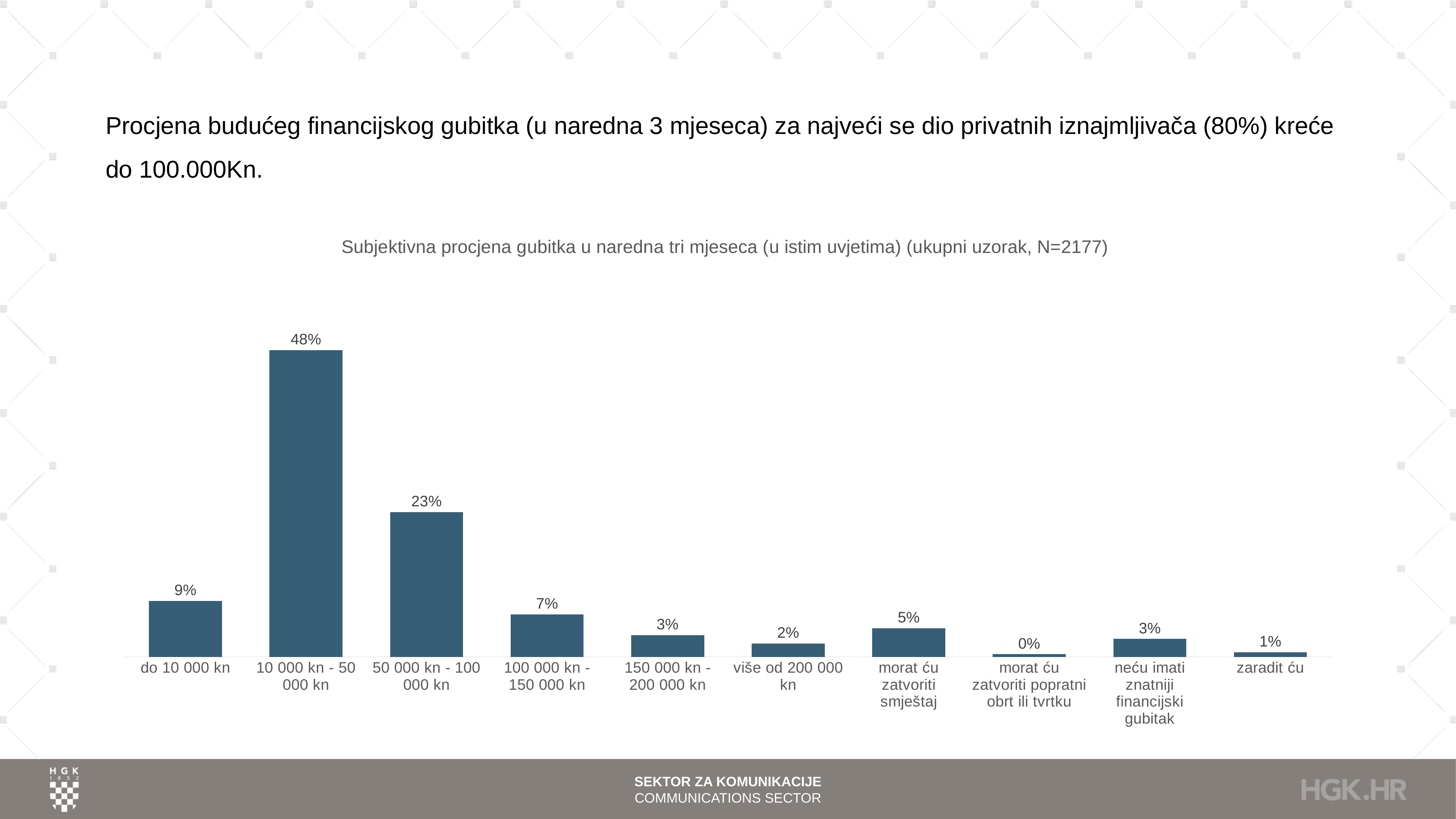
What is the value for the category "10 000 kn - 50 000 kn"? 48% What is the value for the category "zaradit ću"? 1% What is the value for the category "morat ću zatvoriti smještaj"? 5% Which category has the highest value? 10 000 kn - 50 000 kn What kind of chart is shown on the slide? Bar chart What is the title of the chart? Subjektivna procjena gubitka u naredna tri mjeseca (u istim uvjetima) (ukupni uzorak, N=2177) How many categories are shown in the chart? 10 What is the total of the values for "do 10 000 kn", "10 000 kn - 50 000 kn" and "50 000 kn - 100 000 kn"? 80% What is the difference between the values for "10 000 kn - 50 000 kn" and "50 000 kn - 100 000 kn"? 25% What is the value for the category "do 10 000 kn"? 9% Which is larger, the value for "100 000 kn - 150 000 kn" or the value for "morat ću zatvoriti smještaj"? 100 000 kn - 150 000 kn Which category has the lowest value? morat ću zatvoriti popratni obrt ili tvrtku